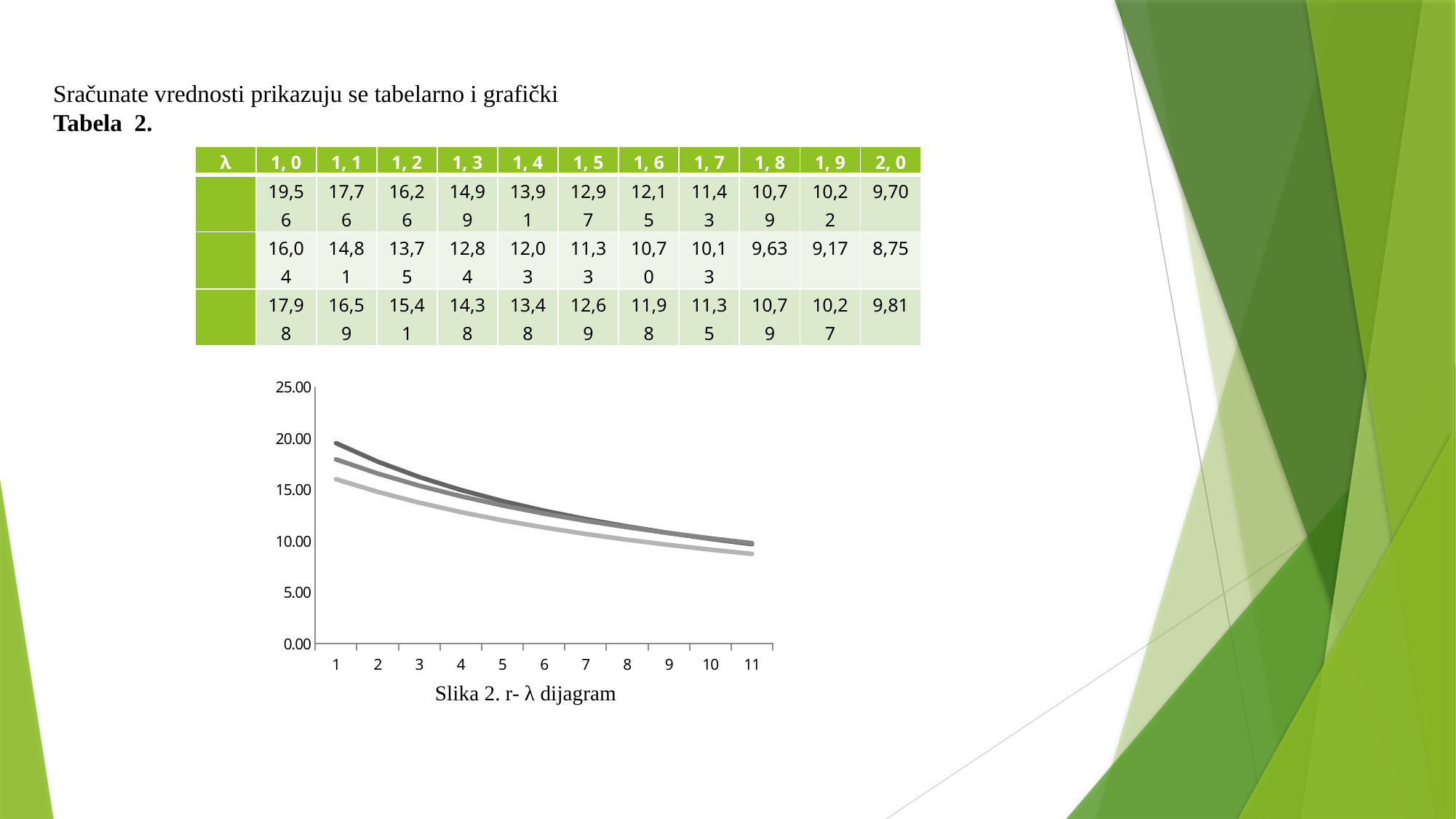
Is the value of the lowest line at x = 11 greater or less than 10.00? less At which x-axis position do the lines reach their lowest values? 11 What is the highest value shown on the chart's y axis? 25.00 How many points are marked along the x axis of the chart? 11 Is the value of the topmost line at x = 1 greater or less than 15.00? greater At which x-axis position do the lines reach their highest values? 1 What kind of chart is shown on the slide? line chart Is the value of the lowest line at x = 6 greater or less than 15.00? less What is the caption written below the chart? Slika 2. r- λ dijagram Do the plotted values rise or fall as the x axis goes from 1 to 11? fall How many lines are plotted on the chart? 3